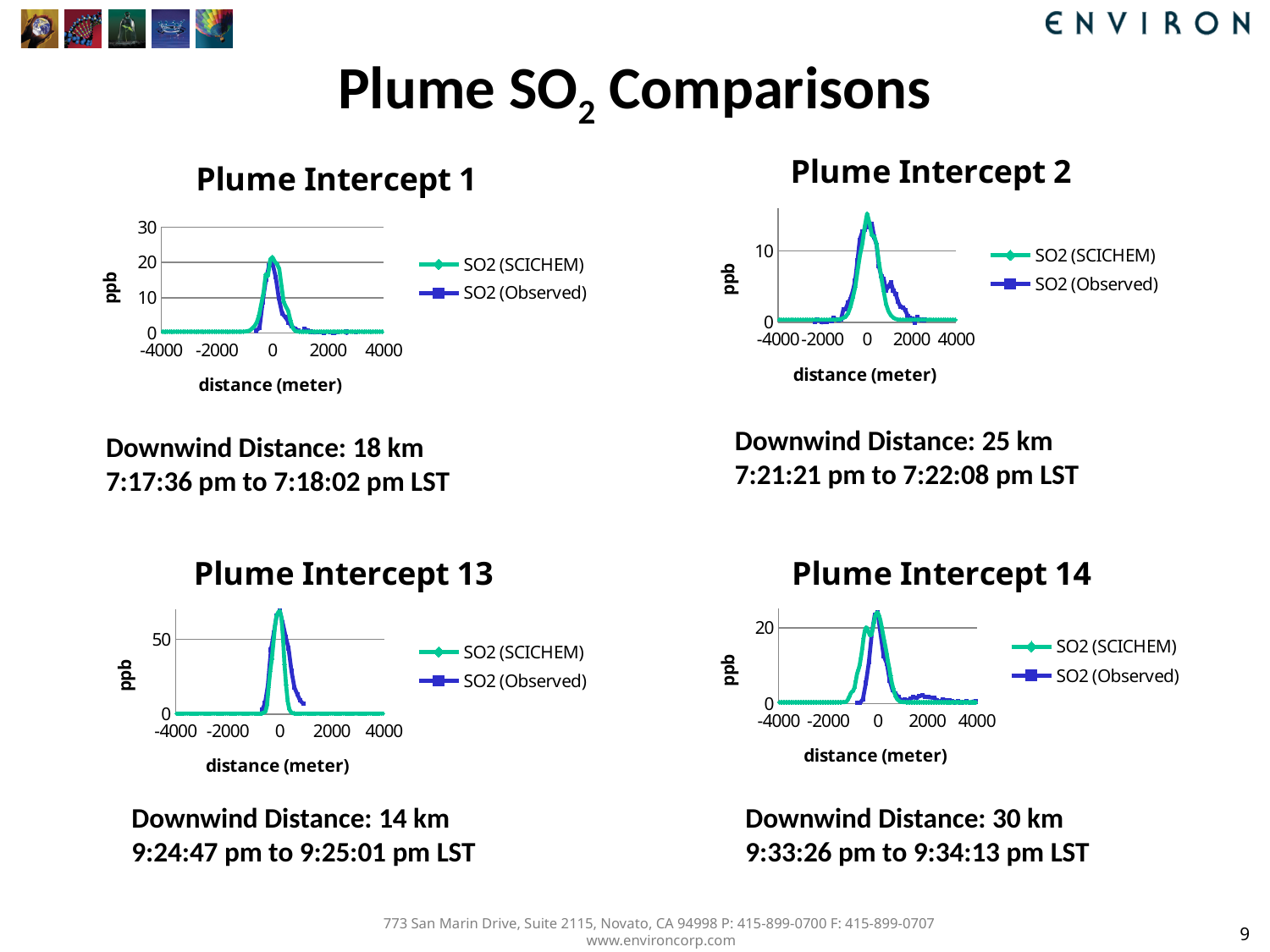
In Plume Intercept 13, is the value of SO2 (SCICHEM) at 4000 meters greater or less than 50? less How many series does the legend of Plume Intercept 13 list? 2 How many series does the legend of Plume Intercept 2 list? 2 In Plume Intercept 1, is the value of SO2 (Observed) at -4000 meters greater or less than 10? less What are the two series named in the legend of Plume Intercept 14? SO2 (SCICHEM) and SO2 (Observed) In Plume Intercept 2, is the peak value of SO2 (SCICHEM) greater or less than 10? greater What kind of chart is Plume Intercept 1? line chart What is the x-axis label of the Plume Intercept 13 chart? distance (meter) What kind of chart is Plume Intercept 14? line chart